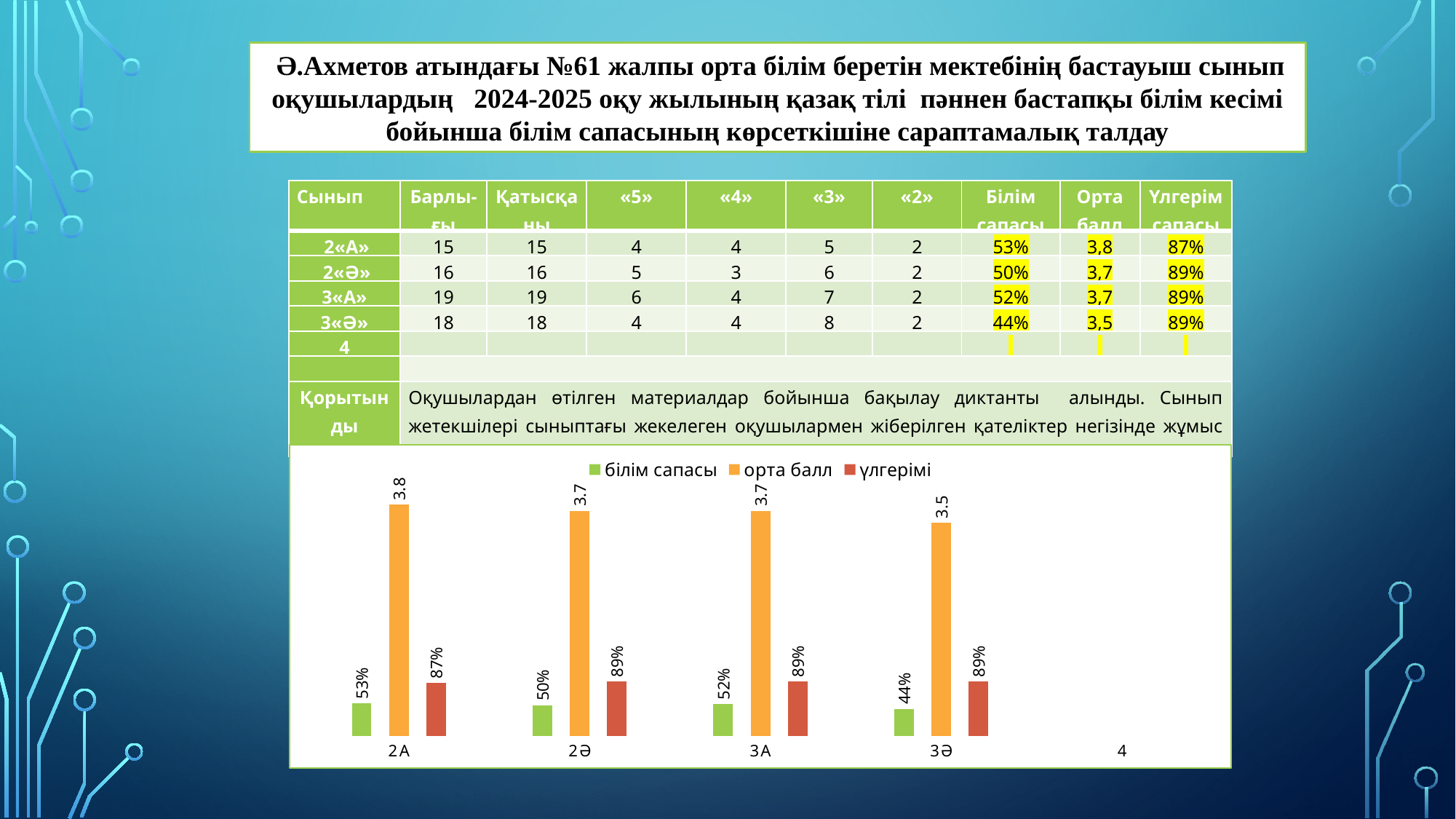
How many series does the chart legend list? 3 What is the білім сапасы value for 3Ә in the chart? 44% Which class has the lowest орта балл in the chart? 3Ә What is the difference between the орта балл of 2А and 3Ә in the chart? 0.3 What is the білім сапасы value for 2Ә in the chart? 50% What is the орта балл value for 2А in the chart? 3.8 Which class has the highest білім сапасы in the chart? 2А Which series in the chart is shown in orange? орта балл What is the difference between the білім сапасы of 2А and 3Ә in the chart? 9% What is the үлгерімі value for 2А in the chart? 87% What type of chart is shown on the slide? bar chart Which is larger in the chart: the білім сапасы of 3А or of 3Ә? 3А